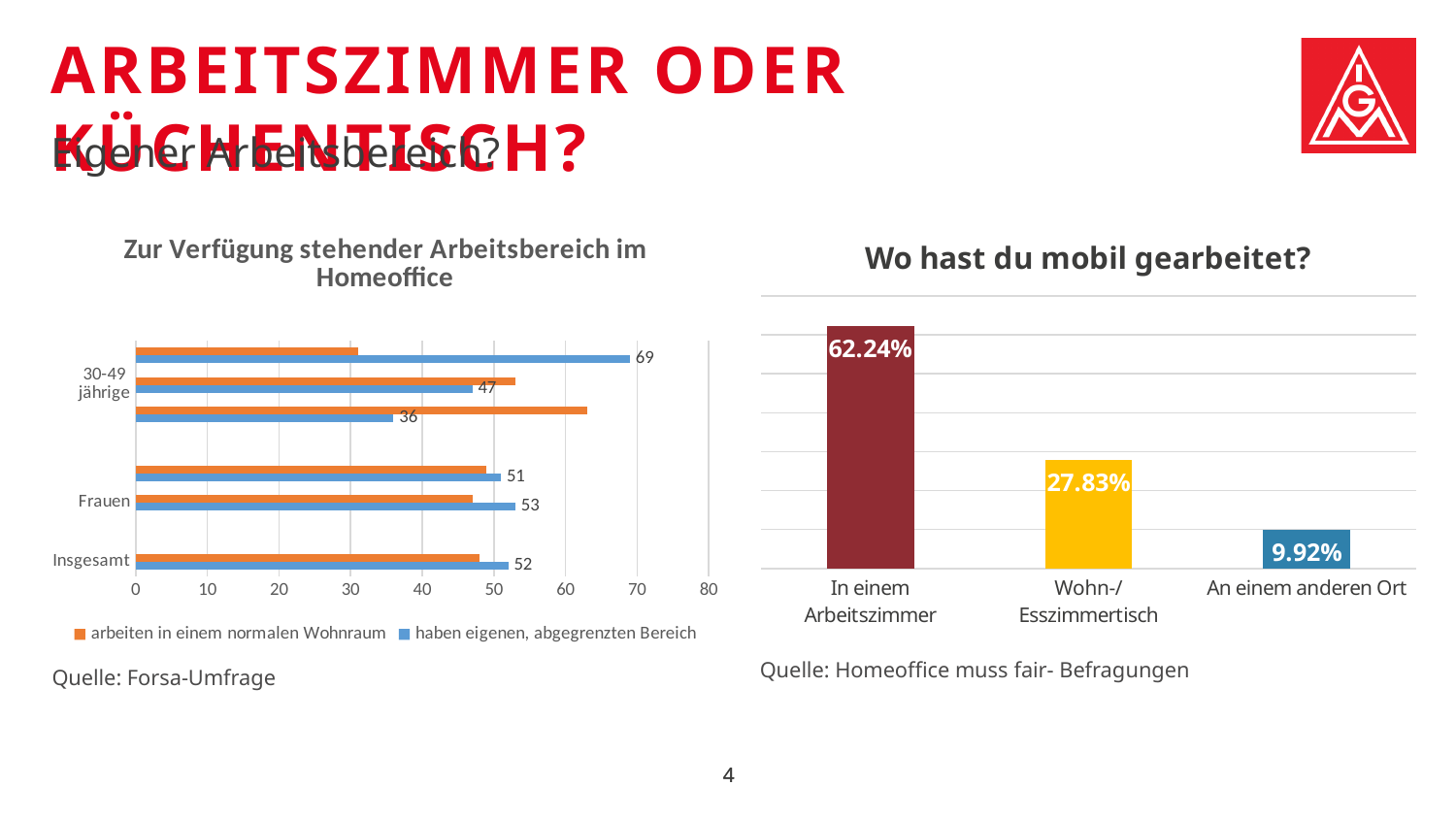
How many categories are shown in the chart 'Wo hast du mobil gearbeitet?'? 3 In the chart 'Wo hast du mobil gearbeitet?', which category has the lowest value? An einem anderen Ort What kind of chart is 'Wo hast du mobil gearbeitet?'? Bar chart In the chart 'Zur Verfügung stehender Arbeitsbereich im Homeoffice', what is the value for 'Insgesamt' in the series 'haben eigenen, abgegrenzten Bereich'? 52 In the chart 'Zur Verfügung stehender Arbeitsbereich im Homeoffice', what is the value for 'Frauen' in the series 'haben eigenen, abgegrenzten Bereich'? 53 In the chart 'Wo hast du mobil gearbeitet?', what is the value for 'An einem anderen Ort'? 9.92% What kind of chart is 'Zur Verfügung stehender Arbeitsbereich im Homeoffice'? Bar chart In the chart 'Zur Verfügung stehender Arbeitsbereich im Homeoffice', is the value for 'Insgesamt' in the series 'arbeiten in einem normalen Wohnraum' greater or less than 40? greater In the chart 'Wo hast du mobil gearbeitet?', what is the difference between 'In einem Arbeitszimmer' and 'Wohn-/Esszimmertisch'? 34.41% In the chart 'Wo hast du mobil gearbeitet?', what is the value for 'In einem Arbeitszimmer'? 62.24% In the chart 'Wo hast du mobil gearbeitet?', which category has the highest value? In einem Arbeitszimmer How many series does the legend of the chart 'Zur Verfügung stehender Arbeitsbereich im Homeoffice' list? 2